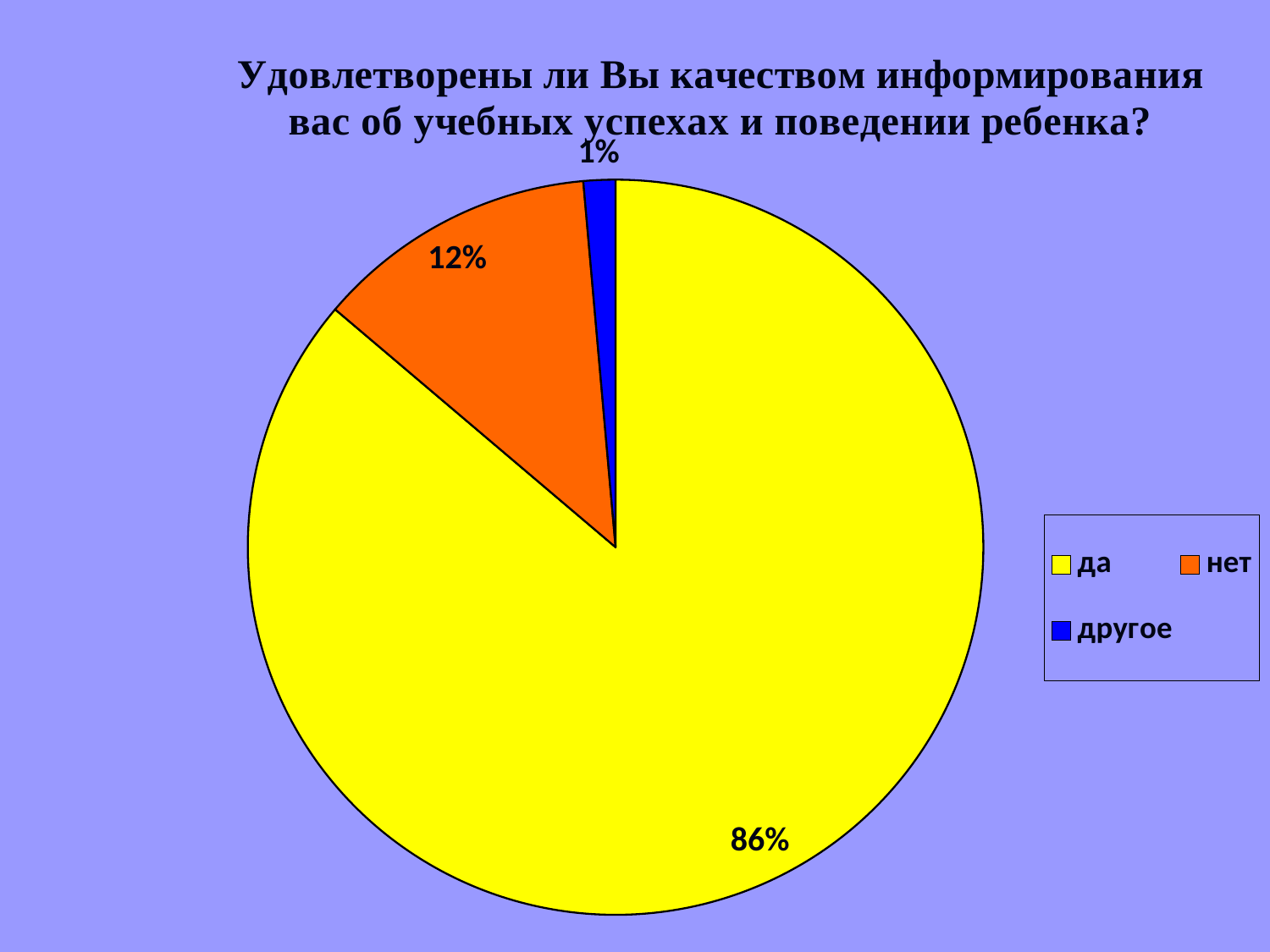
What colour is the slice for "нет"? orange What percentage of the pie is labelled "нет"? 12% What is the difference in percentage points between the "нет" slice and the "другое" slice? 11 Which slice is larger, "нет" or "другое"? нет What kind of chart is shown on the slide? pie chart What is the difference in percentage points between the "да" slice and the "нет" slice? 74 What percentage of the pie is labelled "другое"? 1% Which category has the largest slice of the pie? да How many entries does the legend list? 3 Which category has the smallest slice of the pie? другое How many slices does the pie chart have? 3 What percentage of the pie is labelled "да"? 86%